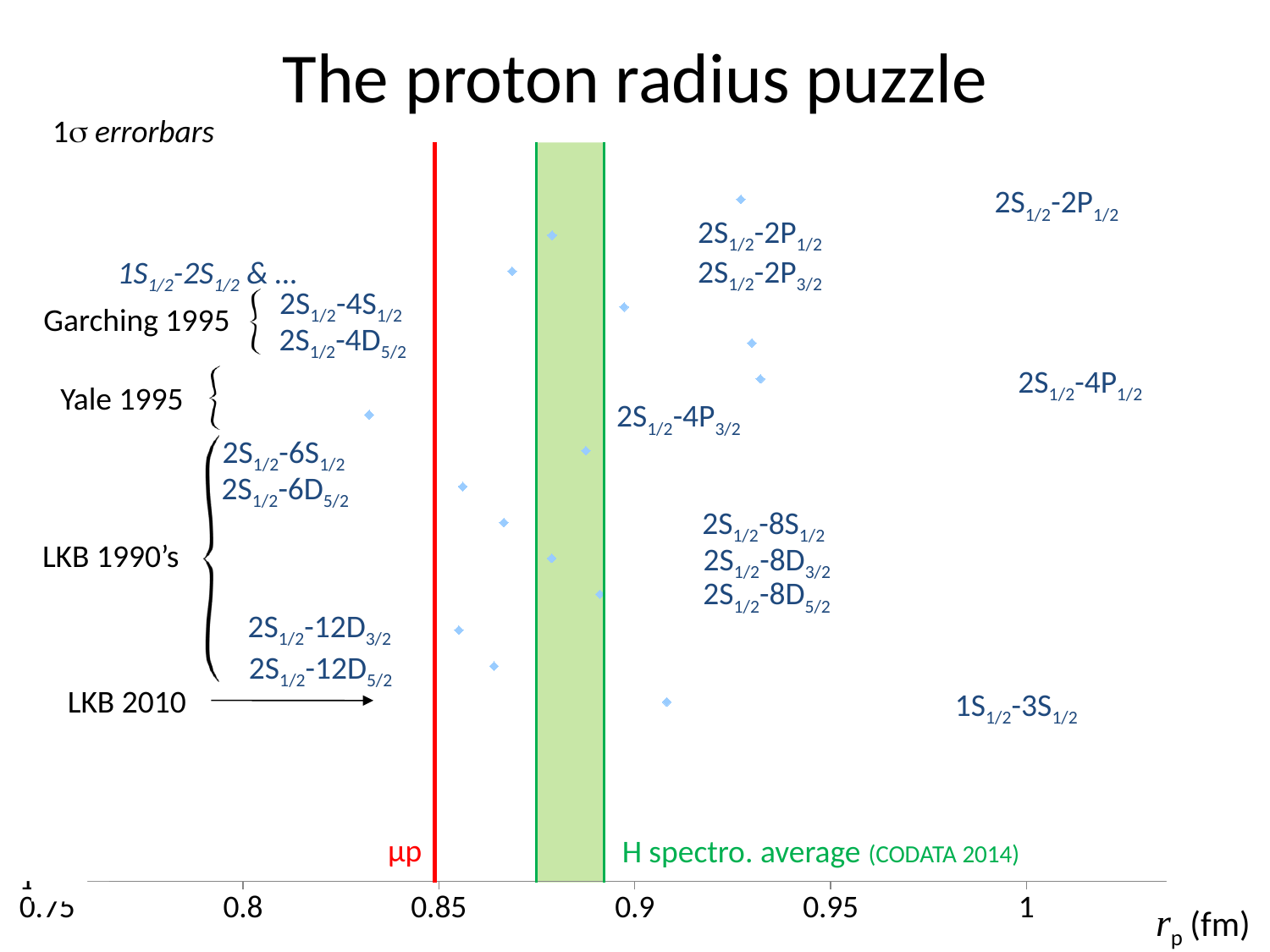
Is the value for the topmost point (2S1/2-2P1/2) greater or less than 0.95? less What is the title of the chart? The proton radius puzzle Which has the larger r_p value, the Yale 1995 point or the LKB 2010 point? LKB 2010 What kind of chart is shown on the slide? scatter plot What quantity and unit are shown on the x axis of the chart? r_p (fm) Is the value for the LKB 2010 (1S1/2-3S1/2) point greater or less than 0.9? greater Is the value for the LKB 2010 point greater or less than 0.95? less Which labelled measurement group has the point with the lowest r_p value? Yale 1995